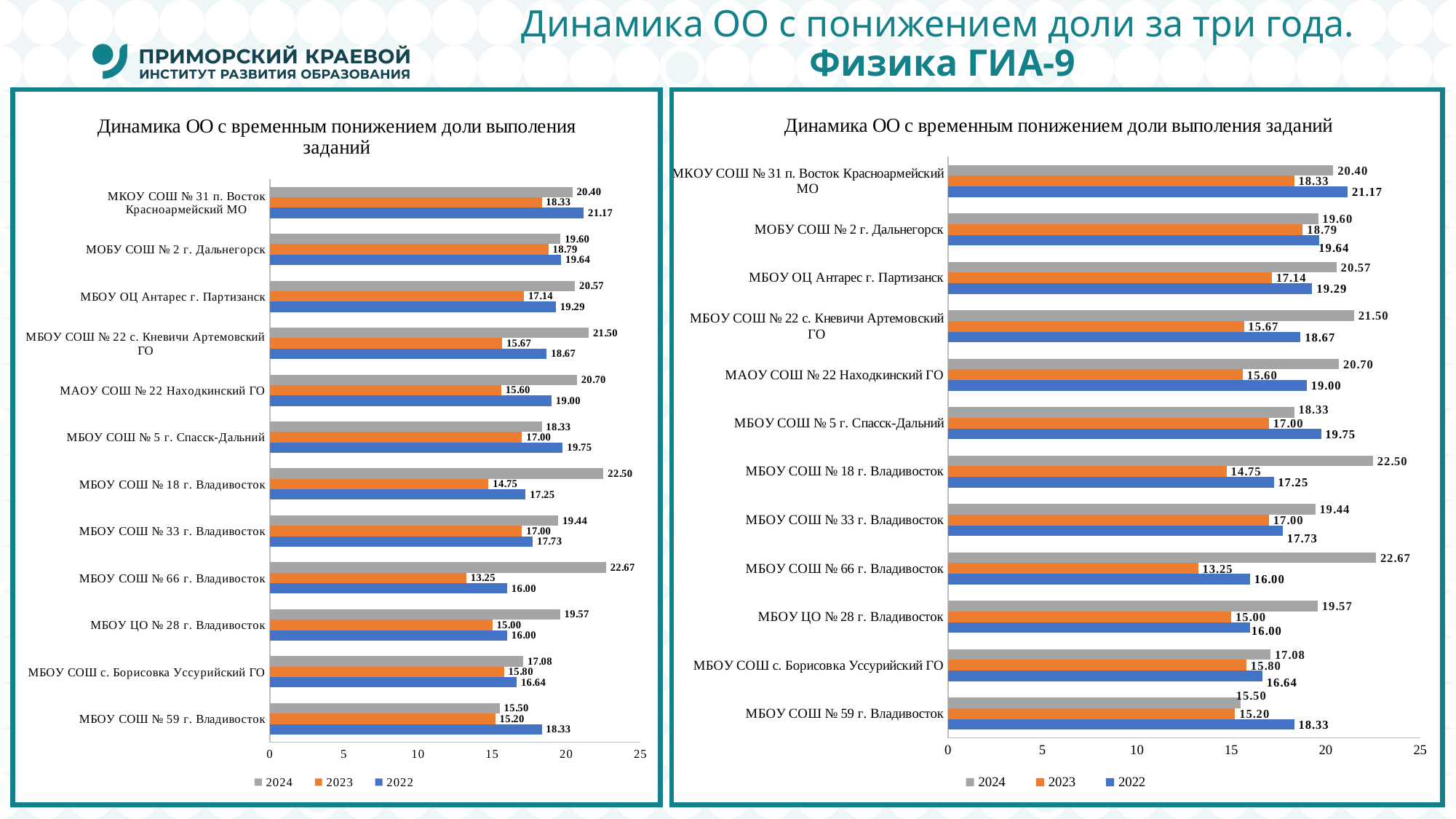
In the left chart, which school has the lowest 2023 value? МБОУ СОШ № 66 г. Владивосток In the left chart, what is the 2022 value for МКОУ СОШ № 31 п. Восток Красноармейский МО? 21.17 In the left chart, is the 2023 value for МБОУ СОШ № 66 г. Владивосток greater or less than 15? less In the right chart, what is the 2023 value for МБОУ СОШ № 22 с. Кневичи Артемовский ГО? 15.67 What type of chart is the right chart? Bar chart How many schools are listed in the right chart? 12 In the right chart, which school has the lowest 2024 value? МБОУ СОШ № 59 г. Владивосток In the left chart, what is the difference between the 2024 and 2023 values for МБОУ СОШ № 18 г. Владивосток? 7.75 In the right chart, which is larger for МБОУ СОШ № 5 г. Спасск-Дальний: the 2022 value or the 2024 value? 2022 value (19.75) In the left chart, what is the 2024 value for МБОУ СОШ № 66 г. Владивосток? 22.67 How many series does the legend of the left chart list? 3 In the right chart, which school has the highest 2024 value? МБОУ СОШ № 66 г. Владивосток